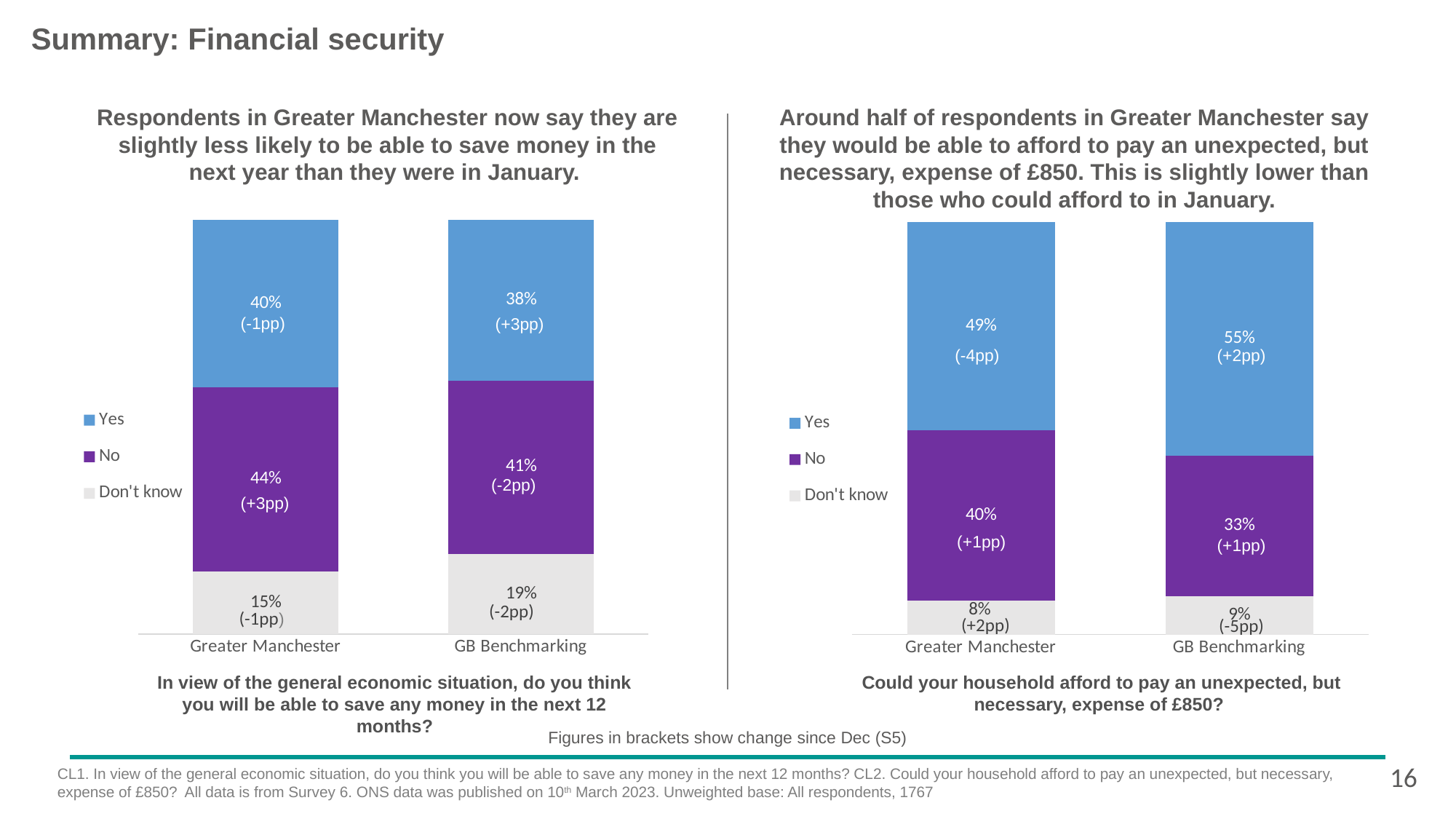
On the right chart, which response category is the smallest for GB Benchmarking? Don't know On the right chart, which has the larger Yes share: Greater Manchester or GB Benchmarking? GB Benchmarking On the left chart, which response category is the largest for Greater Manchester? No On the left chart, what is the difference between the No percentages for Greater Manchester and GB Benchmarking? 3 percentage points On the right chart (affording an unexpected £850 expense), what percentage of GB Benchmarking respondents answered No? 33% On the right chart, what change since December is shown in brackets for the Greater Manchester Yes value? -4pp How many series does the legend of the left chart list? 3 On the right chart, what is the difference between the Yes percentages for GB Benchmarking and Greater Manchester? 6 percentage points What type of chart is used on the right side of the slide? Stacked bar chart On the left chart (saving money in the next 12 months), what percentage of Greater Manchester respondents answered Yes? 40% On the right chart (affording an unexpected £850 expense), what percentage of Greater Manchester respondents answered Yes? 49% On the left chart (saving money in the next 12 months), what percentage of GB Benchmarking respondents answered Don't know? 19%